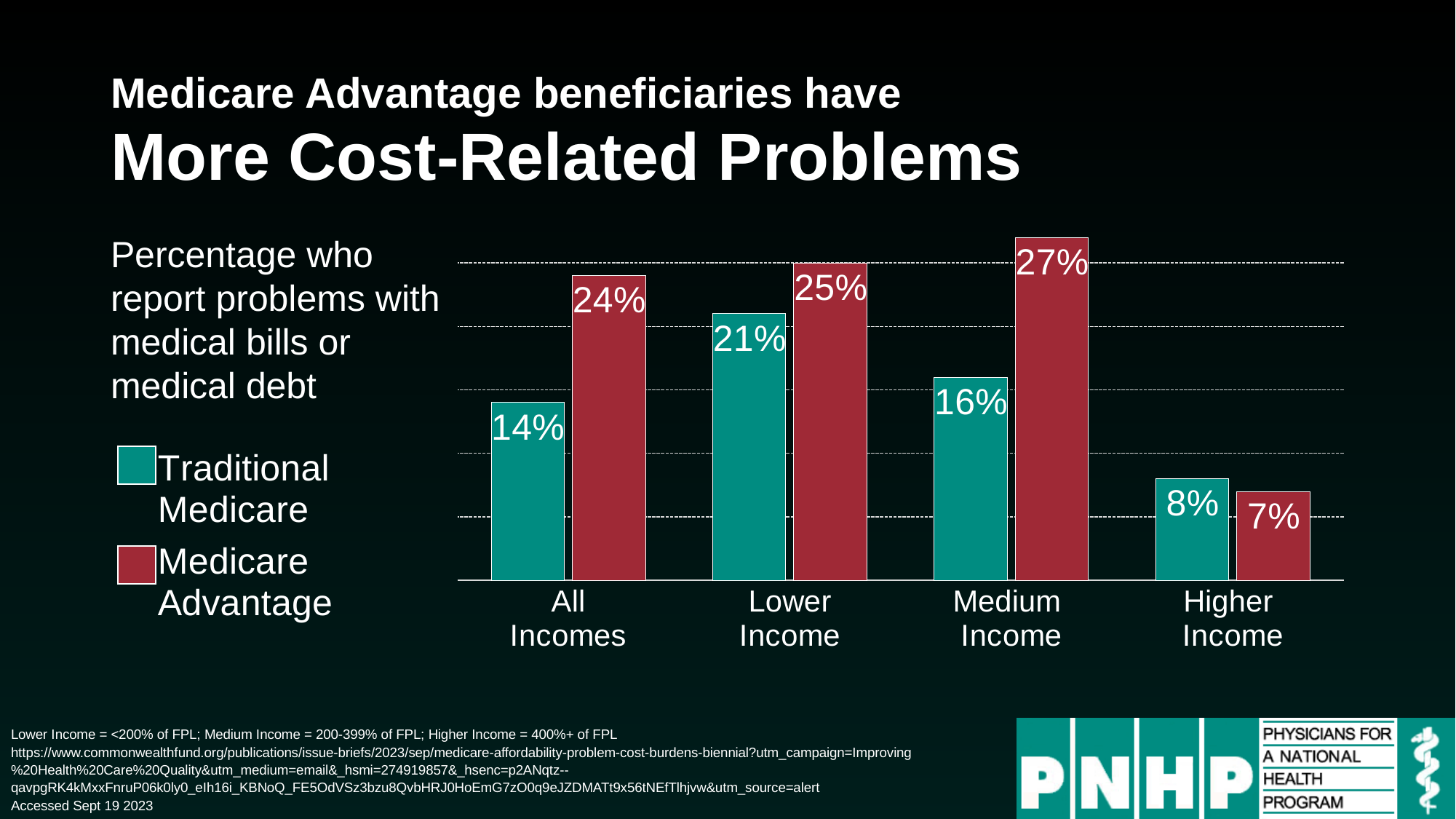
What is the difference between the Medicare Advantage and Traditional Medicare values for All Incomes? 10% How many series does the legend list? 2 What is the value for Traditional Medicare in the Lower Income category? 21% How many income categories are shown on the x axis? 4 What kind of chart is shown on the slide? Bar chart What is the value for Medicare Advantage in the Higher Income category? 7% Which income category has the highest value for Medicare Advantage? Medium Income Which income category has the lowest value for Traditional Medicare? Higher Income What percentage of Medicare Advantage beneficiaries with Medium Income report problems with medical bills or medical debt? 27% In the Higher Income category, which is larger: Traditional Medicare or Medicare Advantage? Traditional Medicare What percentage of Traditional Medicare beneficiaries with All Incomes report problems with medical bills or medical debt? 14% What is the difference between the Medicare Advantage and Traditional Medicare values for Medium Income? 11%